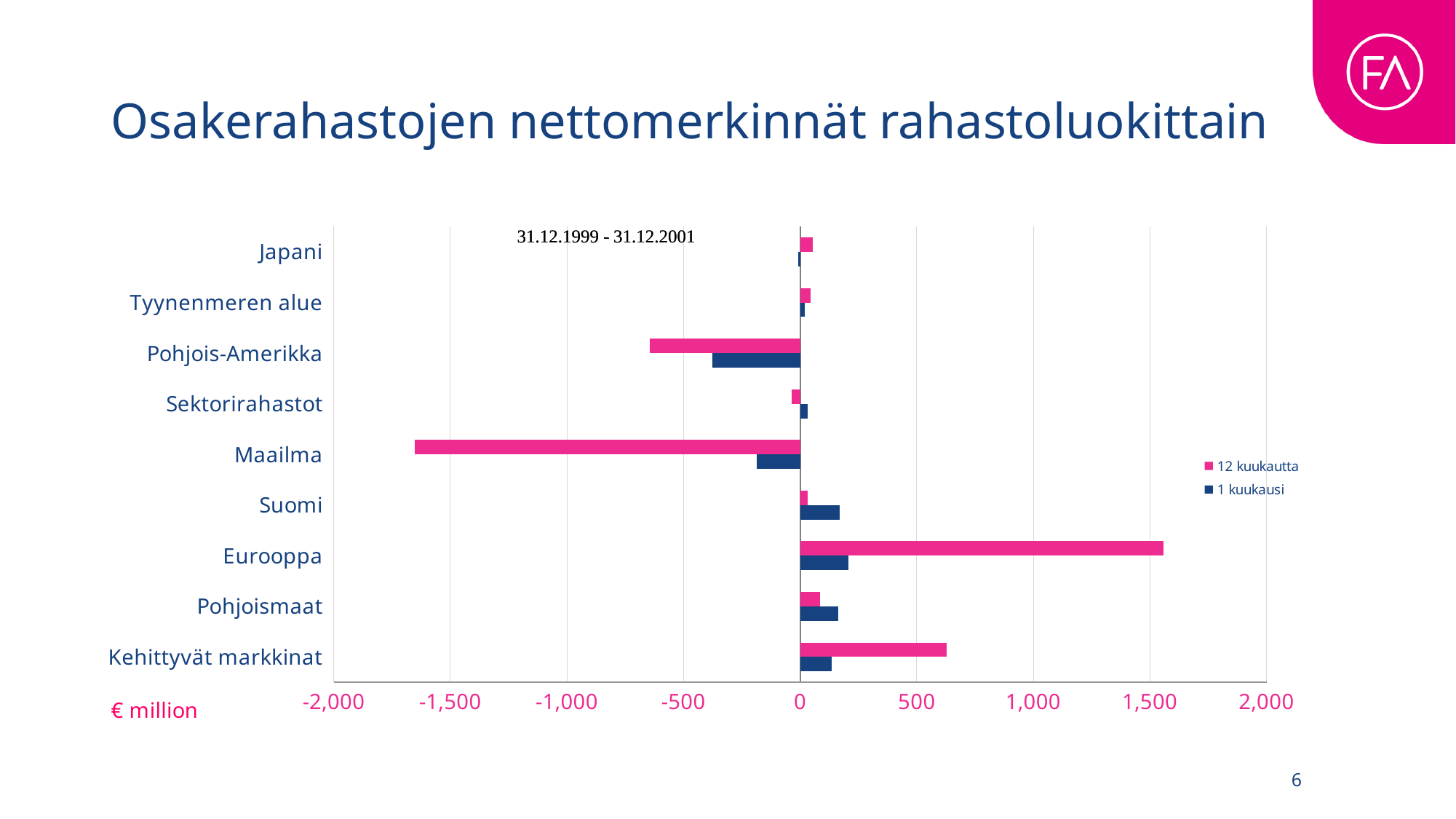
Is the 12 kuukautta value for Maailma greater or less than -1,500? less Which category has the lowest value for the 1 kuukausi series? Pohjois-Amerikka Which category has the lowest value for the 12 kuukautta series? Maailma For the 12 kuukautta series, which is larger: Kehittyvät markkinat or Pohjoismaat? Kehittyvät markkinat What unit is shown below the horizontal axis of the chart? € million Which category has the highest value for the 12 kuukautta series? Eurooppa What kind of chart is shown on the slide? Bar chart Is the 12 kuukautta value for Pohjois-Amerikka greater or less than -500? less How many series does the chart legend list? 2 Is the 12 kuukautta value for Kehittyvät markkinat greater or less than 500? greater How many fund categories are listed on the vertical axis of the chart? 9